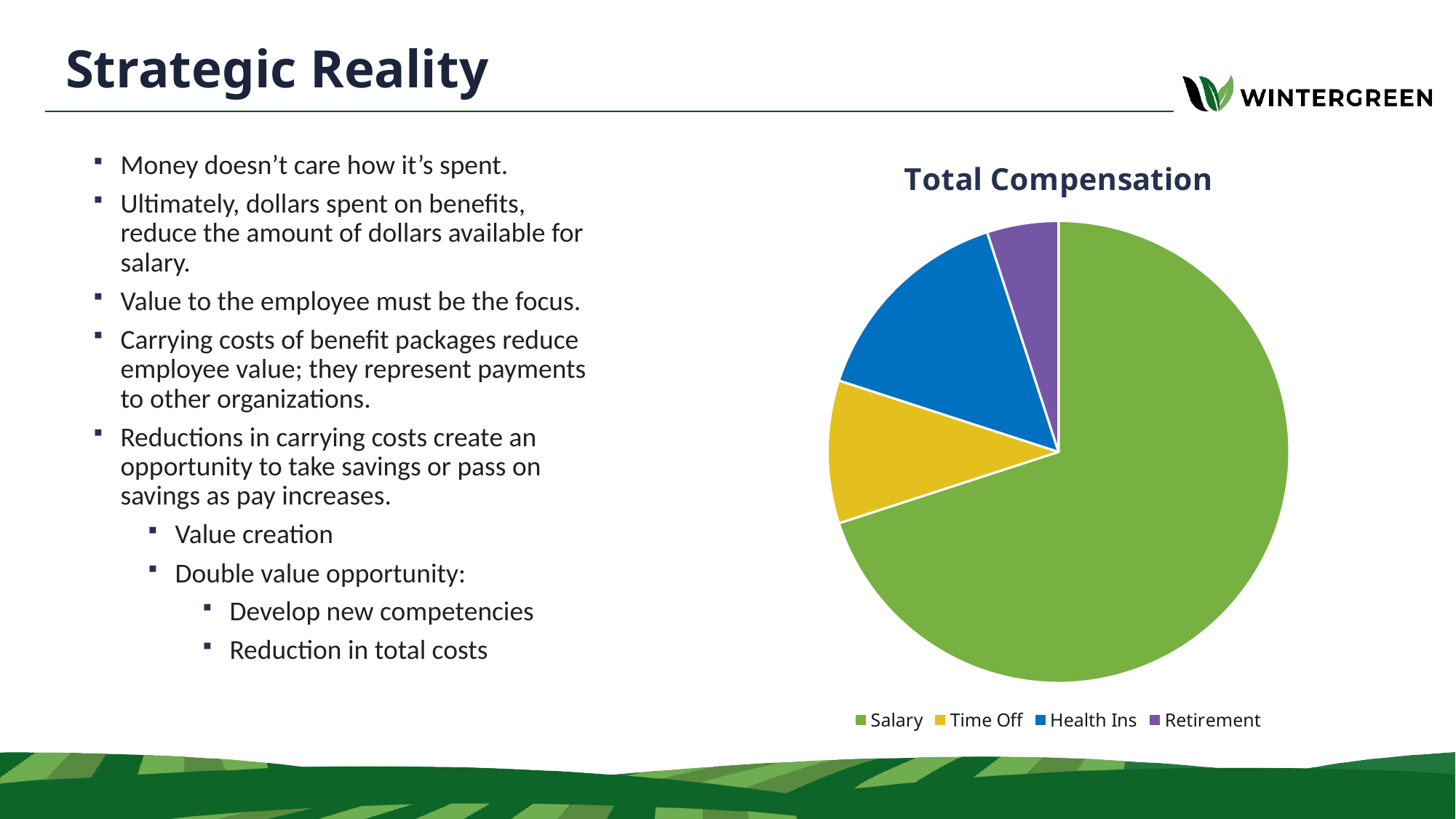
Which slice is larger, Salary or Health Ins? Salary How many entries does the chart legend list? 4 Which category has the smallest slice of the pie? Retirement Which category has the largest slice of the pie? Salary What colour is the Salary slice? Green How many categories does the pie chart show? 4 What kind of chart is shown on the slide? Pie chart Does the Salary slice take up more or less than half of the pie? More Which slice is larger, Health Ins or Time Off? Health Ins Which slice is larger, Time Off or Retirement? Time Off What is the title of the chart? Total Compensation